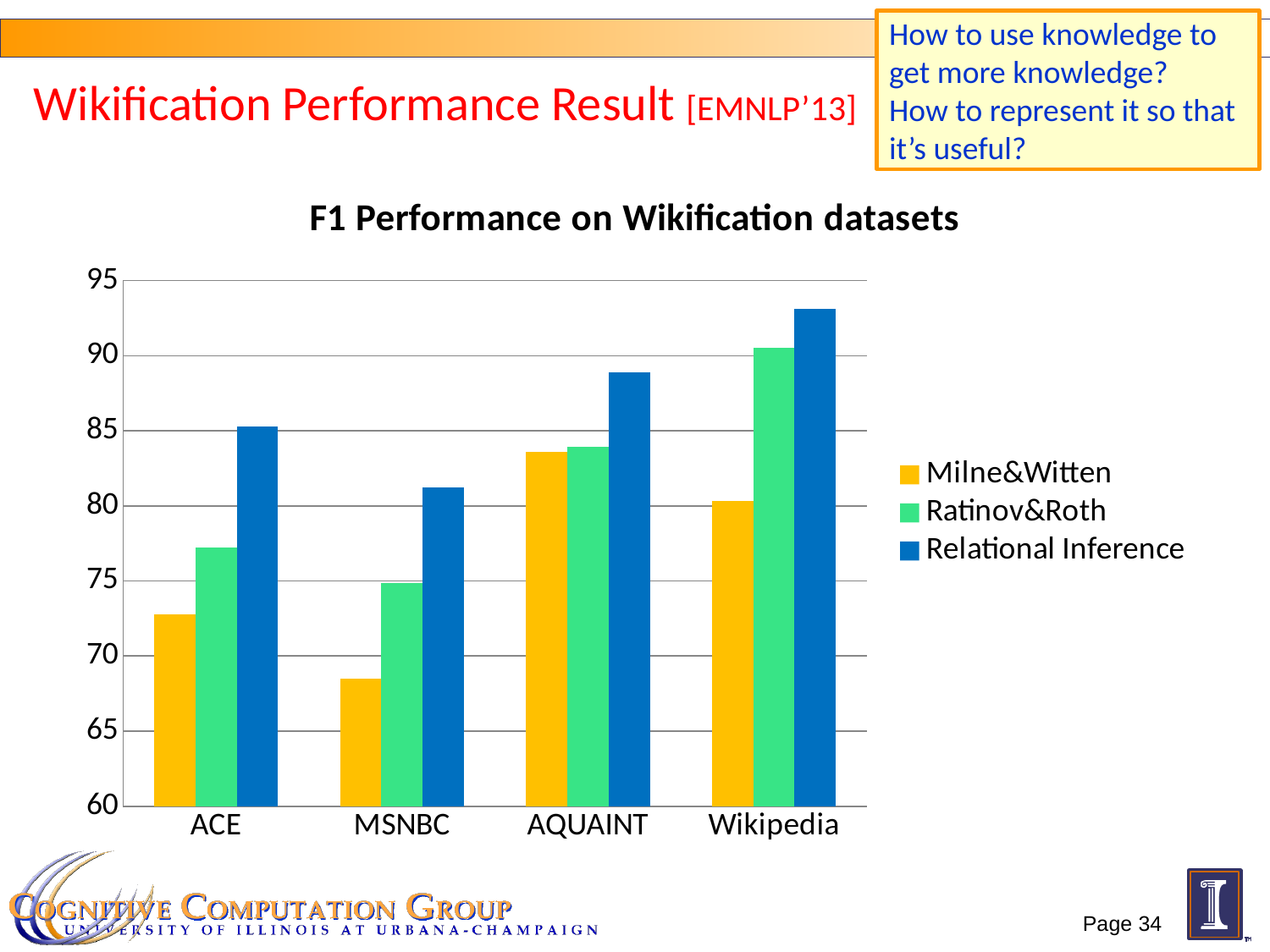
Which dataset has the highest Relational Inference bar? Wikipedia Which series has the highest bar for MSNBC? Relational Inference How many datasets are shown along the x axis? 4 Is the Relational Inference value for Wikipedia greater or less than 90? greater For ACE, which is larger: Ratinov&Roth or Relational Inference? Relational Inference Which dataset has the lowest Milne&Witten bar? MSNBC What is the title of the chart? F1 Performance on Wikification datasets Is the Milne&Witten value for MSNBC greater or less than 70? less How many series does the legend list? 3 What kind of chart is shown on the slide? bar chart Is the Ratinov&Roth value for ACE greater or less than 75? greater For Milne&Witten, which is larger: AQUAINT or Wikipedia? AQUAINT